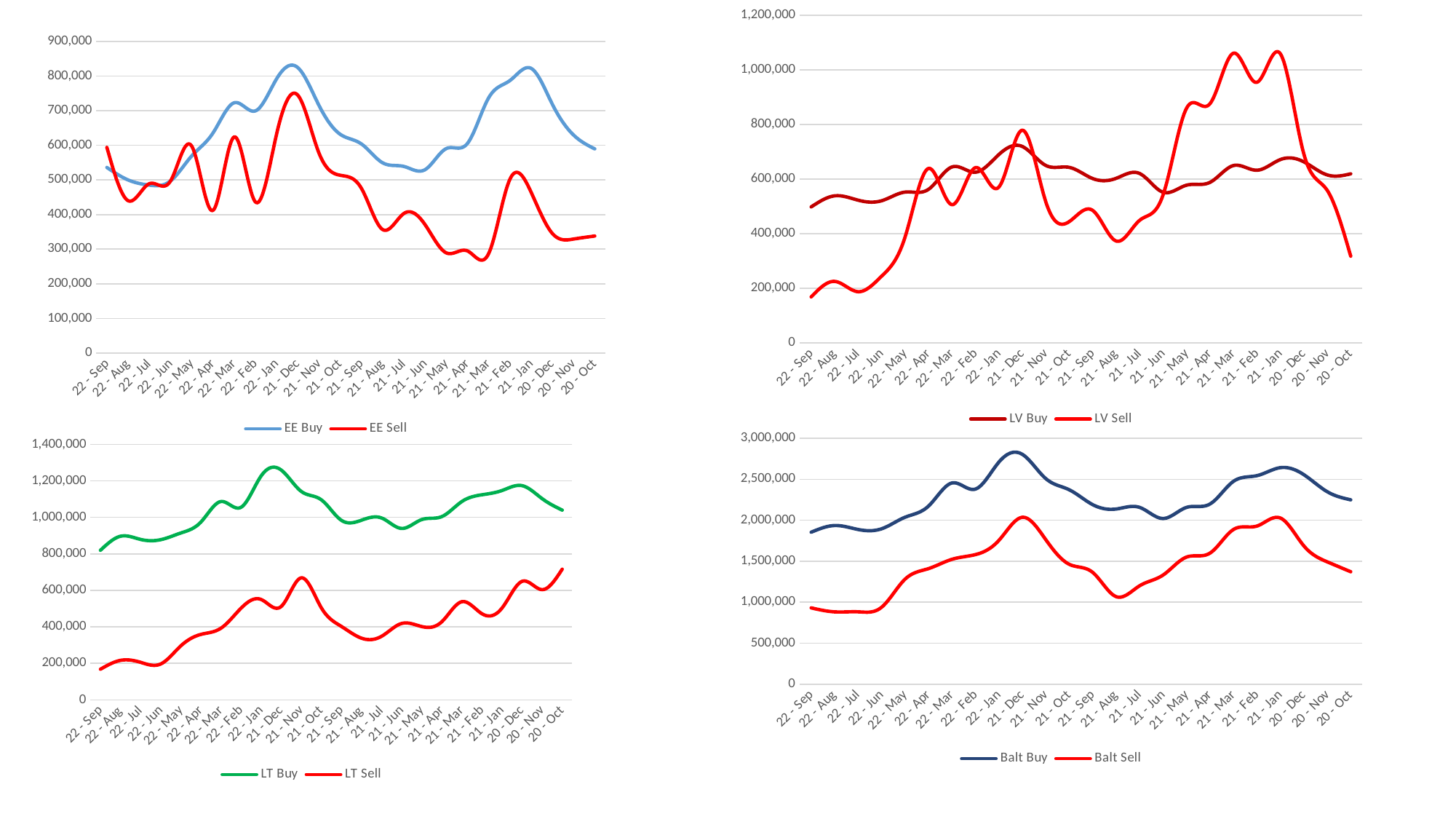
In the bottom-right chart, at which x-axis category does Balt Buy reach its highest value? 21 - Dec What kind of chart is the top-left chart with the EE Buy and EE Sell legend? line chart In the bottom-left chart, which series has the larger value at 22 - Sep, LT Buy or LT Sell? LT Buy In the top-left chart, which series has the larger value at 21 - Jan, EE Buy or EE Sell? EE Buy In the bottom-right chart, is the value of Balt Buy at 22 - Jan greater or less than 2,500,000? greater In the bottom-left chart, is the value of LT Buy at 22 - Jan greater or less than 1,200,000? greater In the top-right chart, is the value of LV Sell at 20 - Oct greater or less than 400,000? less In the bottom-right chart, does Balt Sell rise or fall from 22 - Sep to 22 - Jan? rise What are the two legend entries of the bottom-right chart? Balt Buy, Balt Sell How many series does the legend of the top-left chart list? 2 How many points are plotted along the x axis of the bottom-left chart (LT Buy / LT Sell)? 24